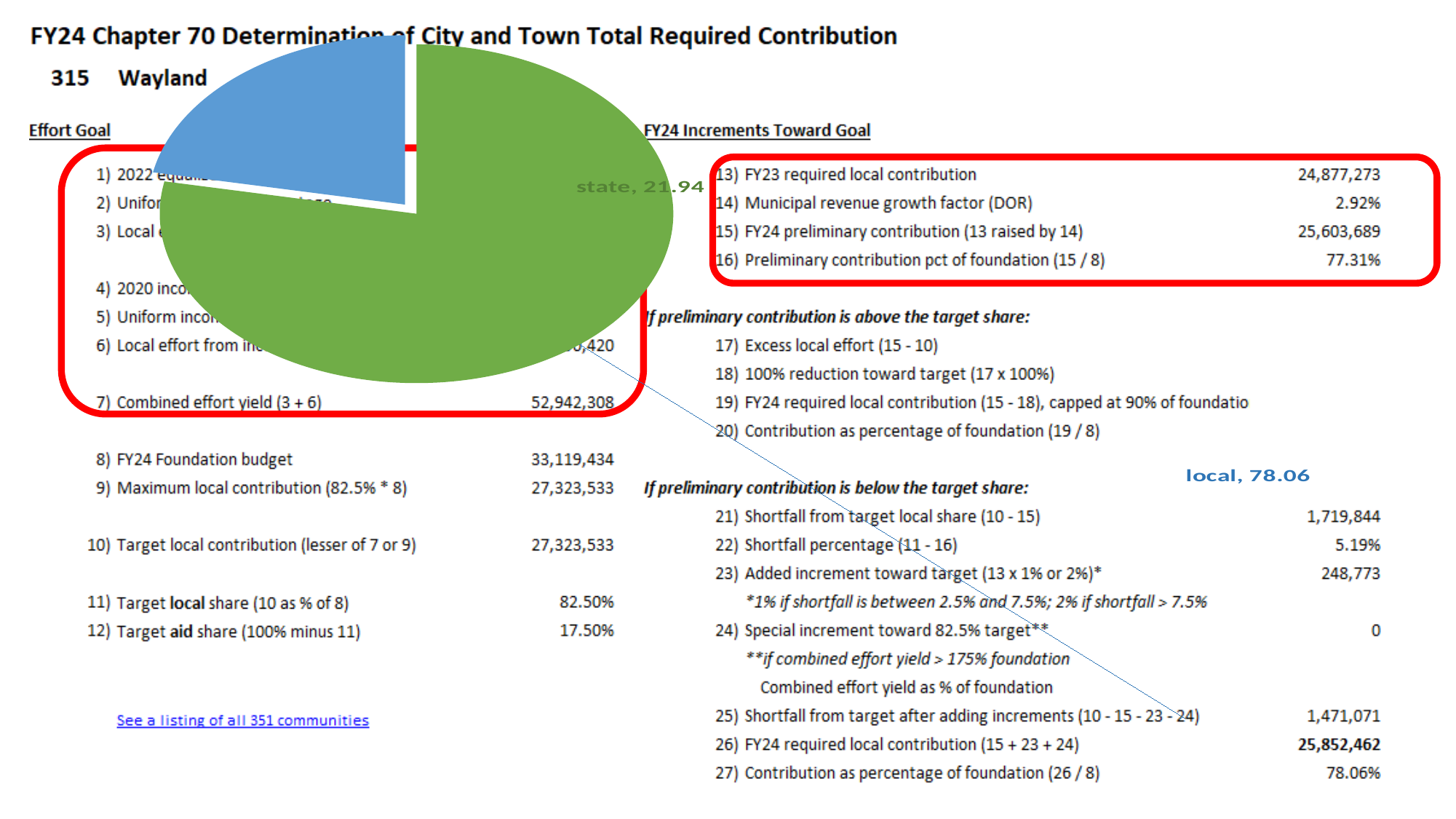
What is the difference between the 'local' value and the 'state' value in the pie chart? 56.12 Which slice of the pie chart is the smallest? state What are the labels of the two slices in the pie chart? state and local Which is larger in the pie chart, the 'local' slice or the 'state' slice? local What do the two slice values in the pie chart add up to? 100 What share of the pie does the 'state' slice represent? 21.94 Which slice of the pie chart is the largest? local What is the value shown for the 'state' slice of the pie chart? 21.94 What is the value shown for the 'local' slice of the pie chart? 78.06 How many slices does the pie chart have? 2 What kind of chart is shown on the slide? pie chart